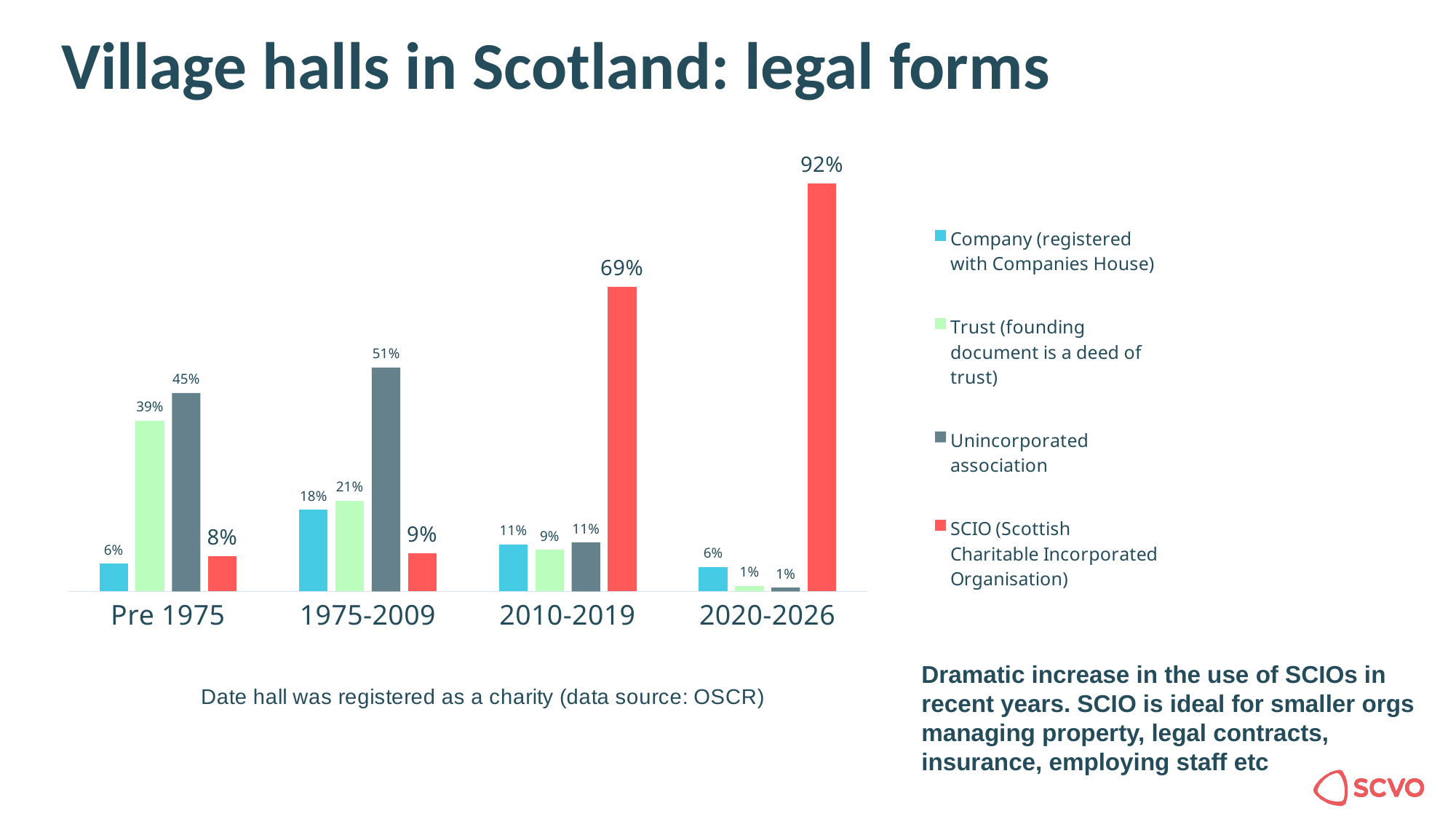
What is the difference between the SCIO share in 2020-2026 and in 2010-2019? 23 percentage points In which period is the SCIO share highest? 2020-2026 How many time periods are shown on the x axis? 4 What is the value for Trust in the 1975-2009 period? 21% Which is larger in the 1975-2009 period: the Trust share or the Company share? Trust What kind of chart is shown on the slide? Bar chart Which legal form has the lowest share in the Pre 1975 period? Company (registered with Companies House) What percentage of village halls registered Pre 1975 are unincorporated associations? 45% What percentage of village halls registered in 2020-2026 are SCIOs? 92% What is the value for Company (registered with Companies House) in the 2010-2019 period? 11% How many series does the legend list? 4 How does the SCIO share change across the periods from Pre 1975 to 2020-2026? It rises